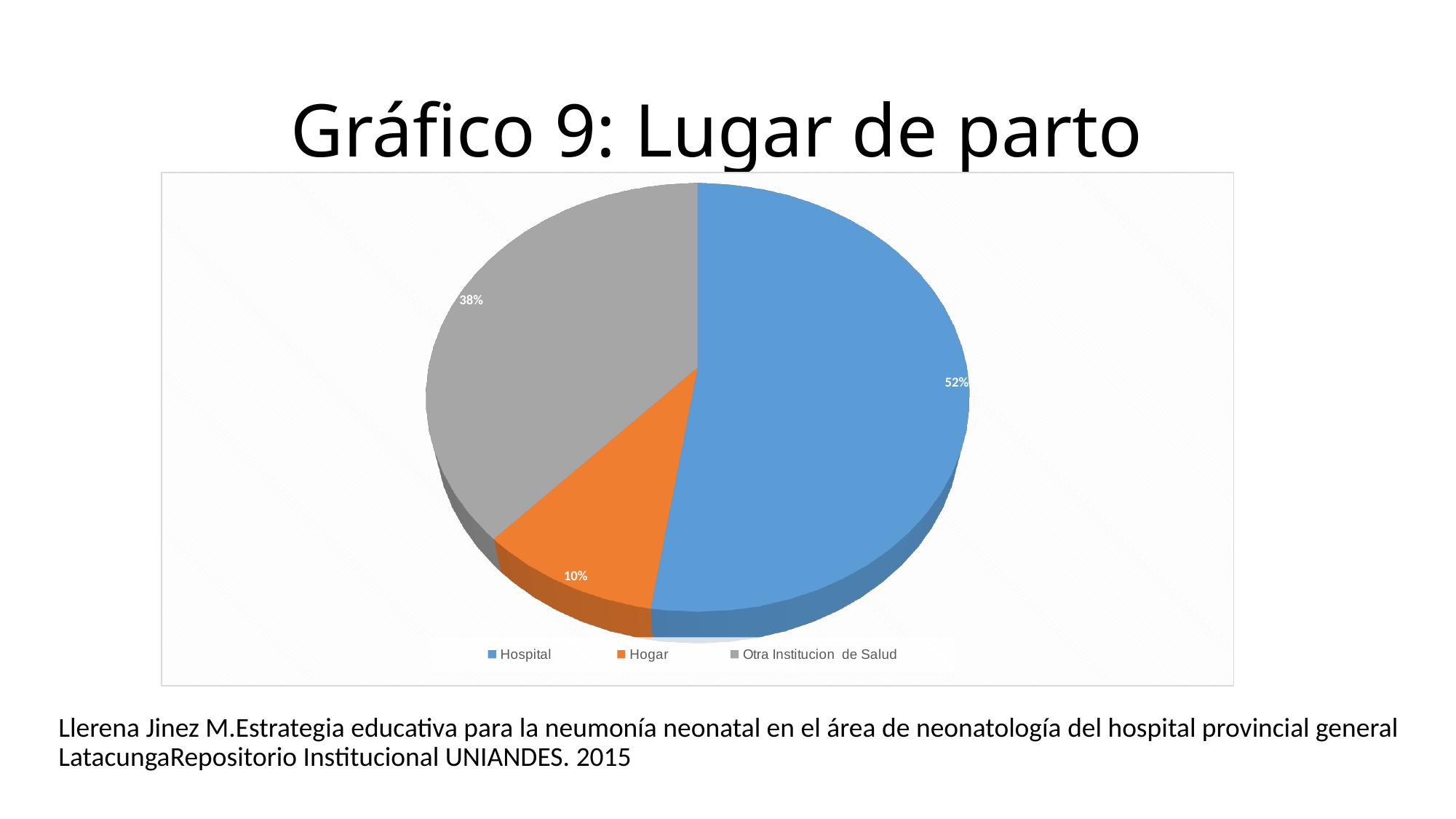
What kind of chart is shown on the slide? Pie chart Which category has the largest share of the pie? Hospital What percentage of the pie does Hogar account for? 10% What is the difference in percentage points between Otra Institucion de Salud and Hogar? 28 Which category has the smallest share of the pie? Hogar What percentage of the pie does Otra Institucion de Salud account for? 38% What is the title of the slide containing the chart? Gráfico 9: Lugar de parto What percentage of the pie does Hospital account for? 52% How many categories does the pie chart show? 3 What is the difference in percentage points between Hospital and Otra Institucion de Salud? 14 What colour is the Hogar slice in the pie chart? Orange Which is larger, the share for Hogar or the share for Otra Institucion de Salud? Otra Institucion de Salud